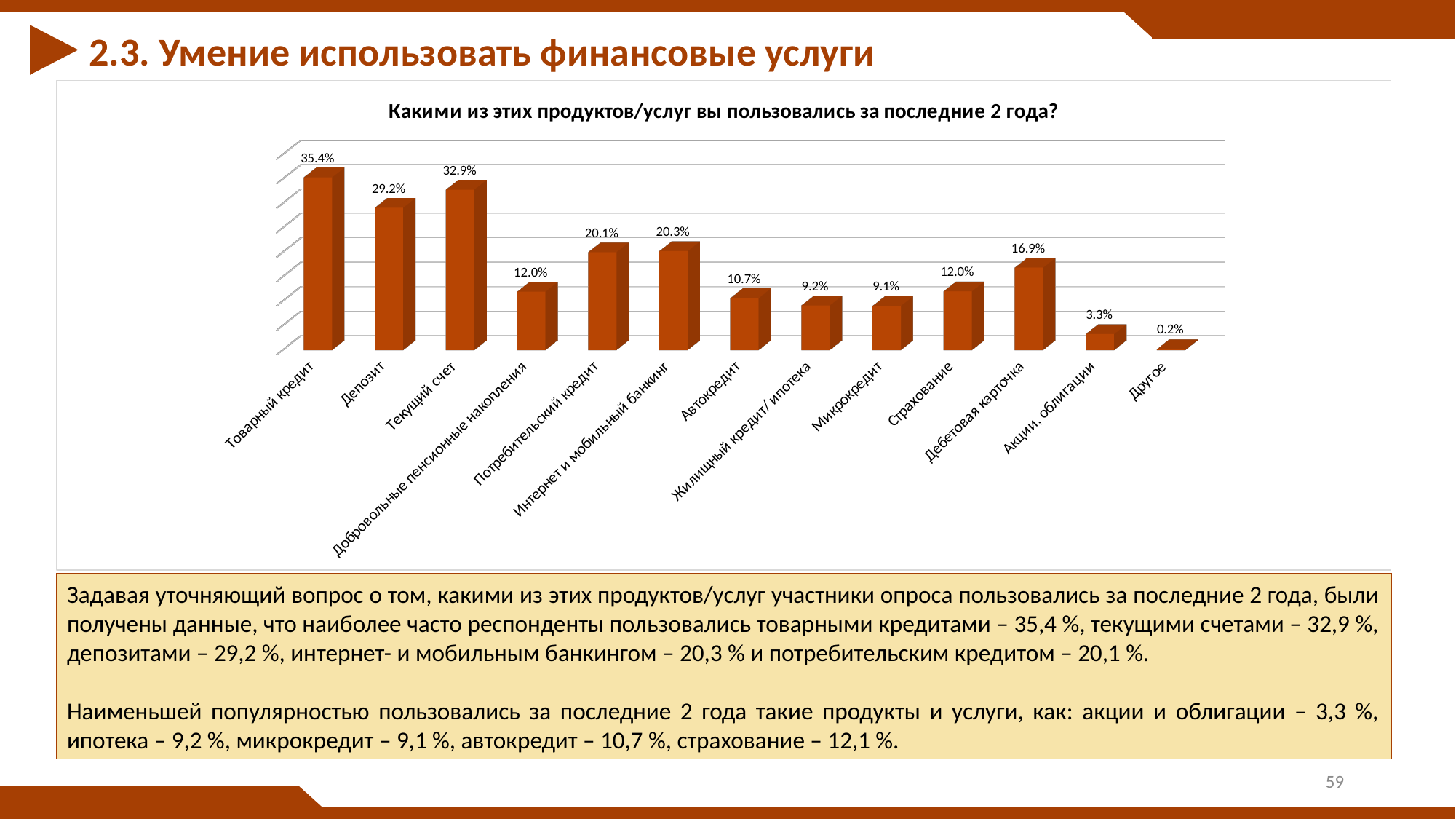
What is the value for Дебетовая карточка? 16.9% Which is larger, the value for Депозит or the value for Текущий счет? Текущий счет What type of chart is shown on the slide? Bar chart What is the value for Акции, облигации? 3.3% What is the difference between the values for Товарный кредит and Текущий счет? 2.5 percentage points Which category has the lowest value? Другое Which category has the highest value? Товарный кредит What is the value for Интернет и мобильный банкинг? 20.3% What is the title of the chart? Какими из этих продуктов/услуг вы пользовались за последние 2 года? Which is larger, the value for Автокредит or the value for Дебетовая карточка? Дебетовая карточка How many categories are shown in the chart? 13 What is the value for Товарный кредит? 35.4%